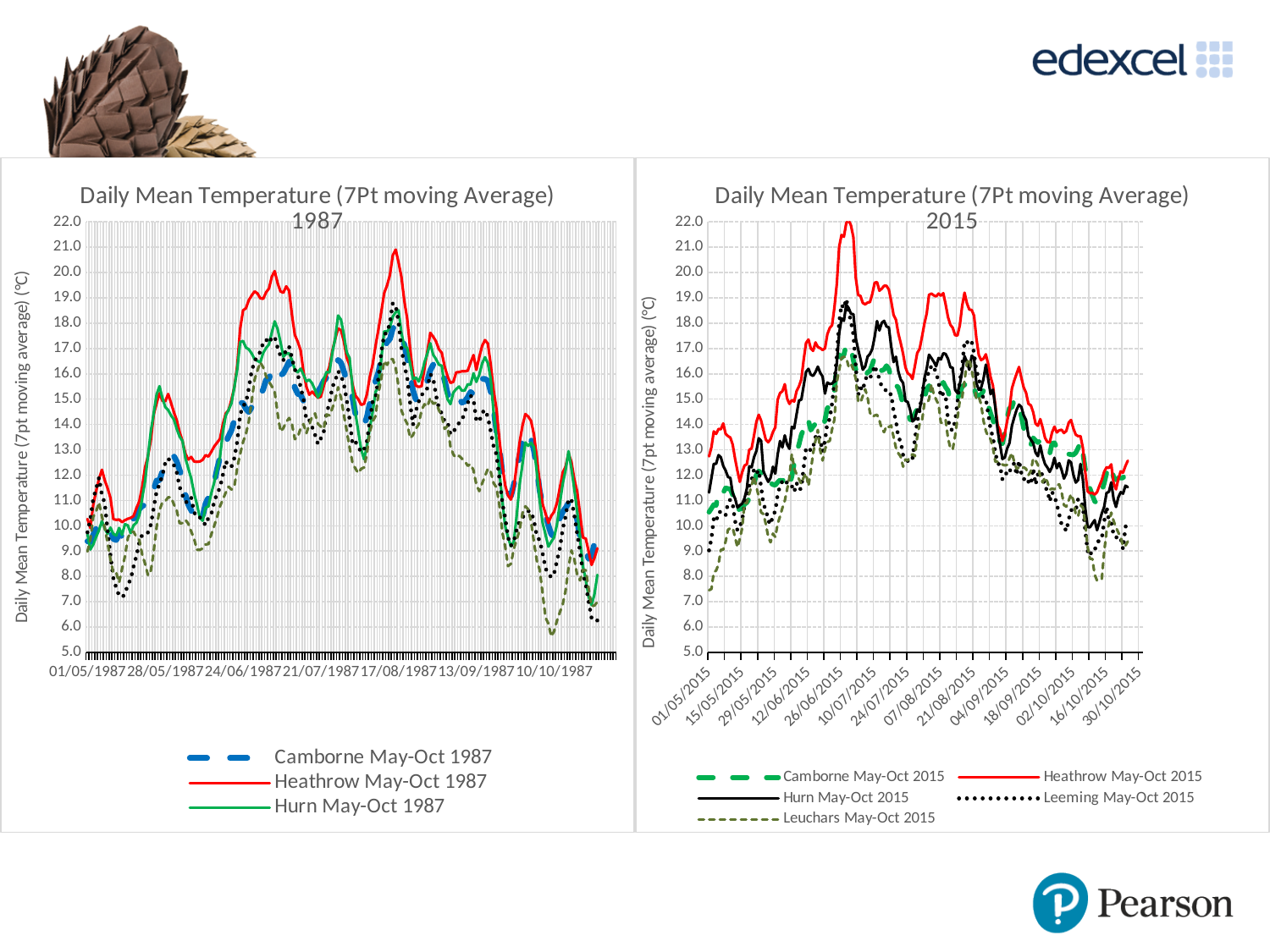
How many series does the legend of the 1987 chart on the left list? 3 In the 1987 chart on the left, is the peak value for Heathrow greater or less than 20.0? greater In the 2015 chart on the right, which series reaches the highest peak? Heathrow May-Oct 2015 What type of chart is the 1987 chart on the left? line chart In the 2015 chart on the right, is the peak value for Hurn greater or less than 19.0? less How many series does the legend of the 2015 chart on the right list? 5 In the 1987 chart on the left, which series reaches the highest peak? Heathrow May-Oct 1987 In the 2015 chart on the right, from late August to the end of October, do the temperatures generally rise or fall? fall What is the y-axis label of the chart on the left? Daily Mean Temperature (7pt moving average) (°C) In the 2015 chart on the right, which series is generally higher, Heathrow or Leuchars? Heathrow May-Oct 2015 What is the title of the chart on the right? Daily Mean Temperature (7Pt moving Average) 2015 In the 2015 chart on the right, is the peak value for Heathrow greater or less than 21.0? greater